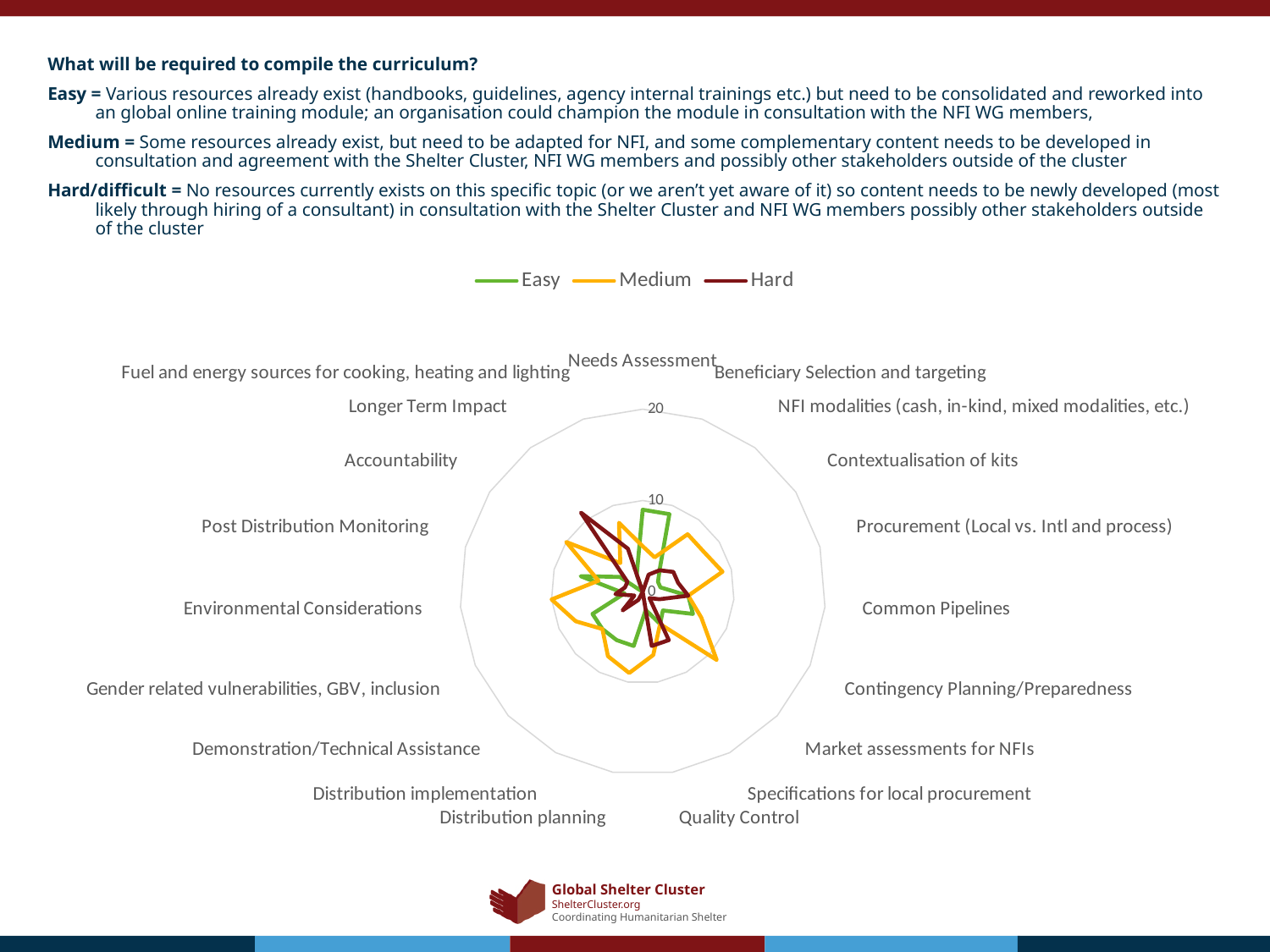
How many series does the chart legend list? 3 Is the Medium value for Procurement (Local vs. Intl and process) greater or less than 20? less How many categories (axes) does the radar chart have? 19 Is the Hard value for Fuel and energy sources for cooking, heating and lighting greater or less than 20? less What colour is the line for the Hard series? Dark red Which category label appears at the top of the radar chart? Needs Assessment Is the Easy value for Needs Assessment greater or less than 20? less What are the three series named in the chart legend? Easy, Medium, Hard What kind of chart is shown on the slide? Radar chart What is the highest value shown on the chart's radial axis? 20